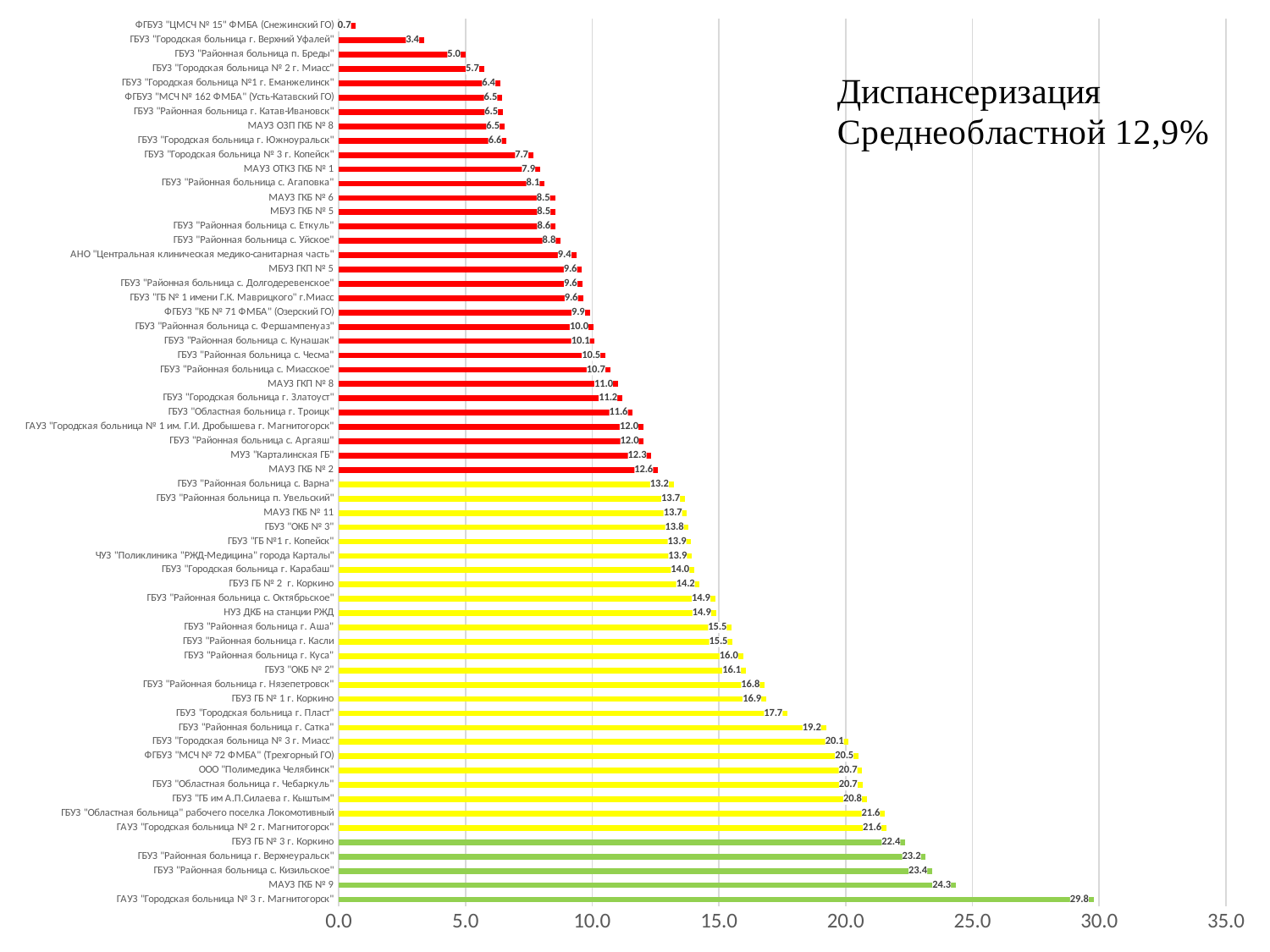
Is the value for ООО "Полимедика Челябинск" greater or less than 20.0? greater Which has a larger value: ГБУЗ "Районная больница г. Аша" or ГБУЗ "Городская больница г. Пласт"? ГБУЗ "Городская больница г. Пласт" What is the value for ГАУЗ "Городская больница № 3 г. Магнитогорск"? 29.8 What is the title text shown on the slide? Диспансеризация Среднеобластной 12,9% What is the value for МАУЗ ГКБ № 9? 24.3 What type of chart is shown on the slide? bar chart What is the difference between the values for ГАУЗ "Городская больница № 3 г. Магнитогорск" and МАУЗ ГКБ № 9? 5.5 Which category has the lowest value? ФГБУЗ "ЦМСЧ № 15" ФМБА (Снежинский ГО) What is the value for ГБУЗ "Городская больница г. Златоуст"? 11.2 Which category has the highest value? ГАУЗ "Городская больница № 3 г. Магнитогорск" What is the value for ГБУЗ "Районная больница г. Сатка"? 19.2 What is the average regional value (Среднеобластной) stated in the text on the slide? 12,9%